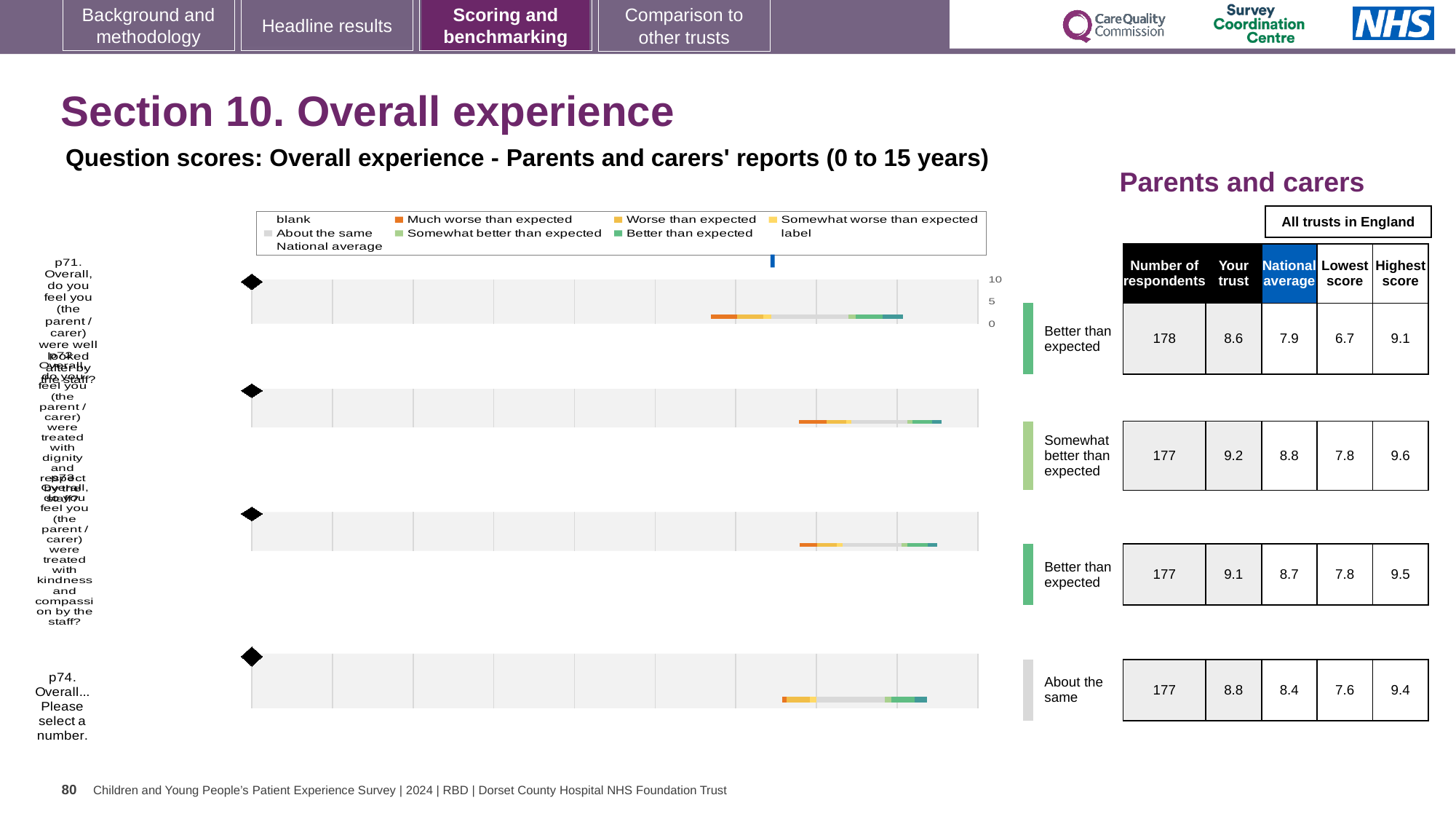
How many respondents answered p71? 178 What is the title of the question scores chart? Question scores: Overall experience - Parents and carers' reports (0 to 15 years) What is the 'Your trust' score for p74 (Overall... Please select a number)? 8.8 What benchmark category is shown for p74? About the same Which question has the highest 'Your trust' score? p72 (treated with dignity and respect) How many questions (rows) are plotted in the question scores chart? 4 What is the highest score across all trusts in England for p72? 9.6 What is the national average score for p71 (were you well looked after by the staff)? 7.9 For p73, which is larger: the 'Your trust' score or the national average? Your trust (9.1) For p72, how much higher is the 'Your trust' score than the national average? 0.4 Which question has the lowest 'Your trust' score? p71 (well looked after by the staff) What kind of chart is used to show the question scores on this slide? bar chart